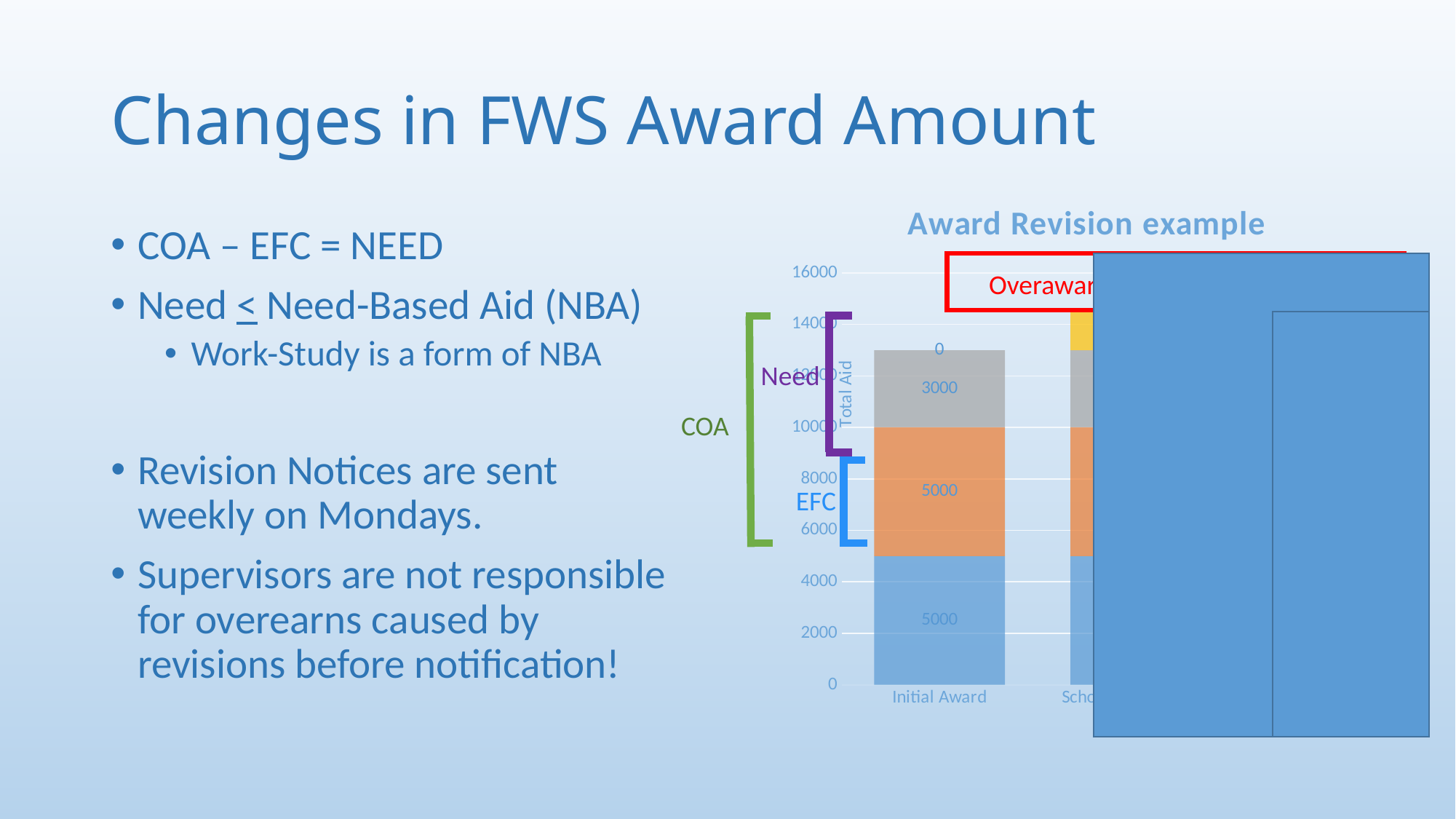
What kind of chart is shown on the slide? Stacked bar chart What is the value of the top (yellow) segment of the Initial Award bar? 0 What is the title of the chart on the slide? Award Revision example What is the value of the gray segment of the Initial Award bar? 3000 What is the value of the bottom (blue) segment of the Initial Award bar? 5000 What is the highest value shown on the vertical axis of the chart? 16000 What is the label on the vertical axis of the chart? Total Aid What is the value of the orange segment of the Initial Award bar? 5000 What is the difference between the orange segment and the gray segment of the Initial Award bar? 2000 What is the total of the Initial Award stacked bar? 13000 Is the total of the Initial Award bar greater or less than 12000? greater Which is larger in the Initial Award bar, the orange segment or the gray segment? Orange segment